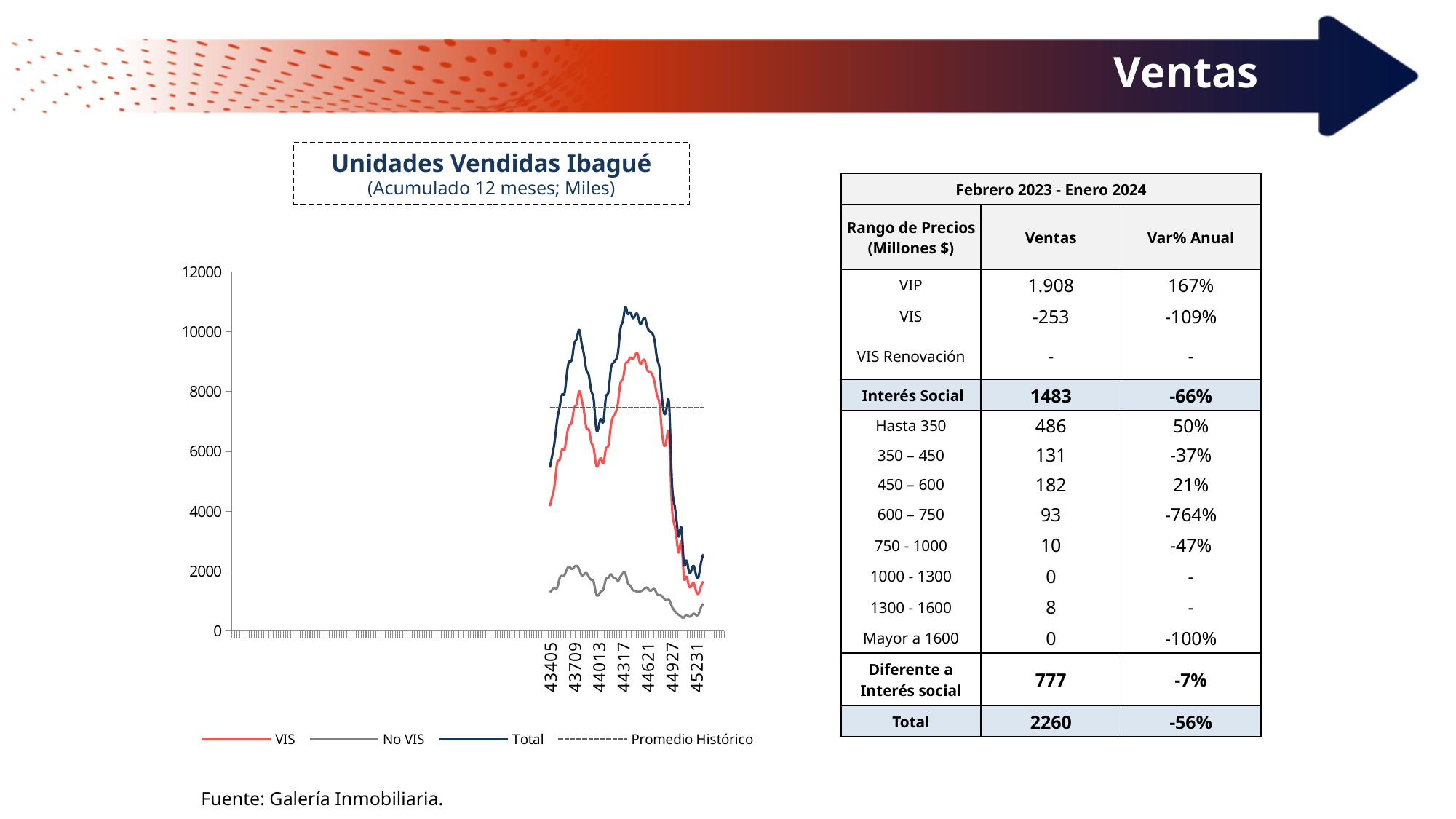
In the "Unidades Vendidas Ibagué" chart, is the Promedio Histórico line greater or less than 6000? greater What kind of chart is "Unidades Vendidas Ibagué"? line chart How many series does the legend of the "Unidades Vendidas Ibagué" chart list? 4 What is the subtitle shown under the title "Unidades Vendidas Ibagué"? (Acumulado 12 meses; Miles) In the "Unidades Vendidas Ibagué" chart, is the peak value of the No VIS series greater or less than 4000? less In the "Unidades Vendidas Ibagué" chart, which series reaches the highest values? Total In the "Unidades Vendidas Ibagué" chart, which series stays lowest throughout? No VIS In the "Unidades Vendidas Ibagué" chart, is the Promedio Histórico line greater or less than 8000? less In the "Unidades Vendidas Ibagué" chart, which is larger at the x-axis point 44317: the VIS series or the No VIS series? VIS In the "Unidades Vendidas Ibagué" chart, do the Total values rise or fall between 44621 and 44927 on the x axis? fall What are the legend entries of the "Unidades Vendidas Ibagué" chart? VIS, No VIS, Total, Promedio Histórico